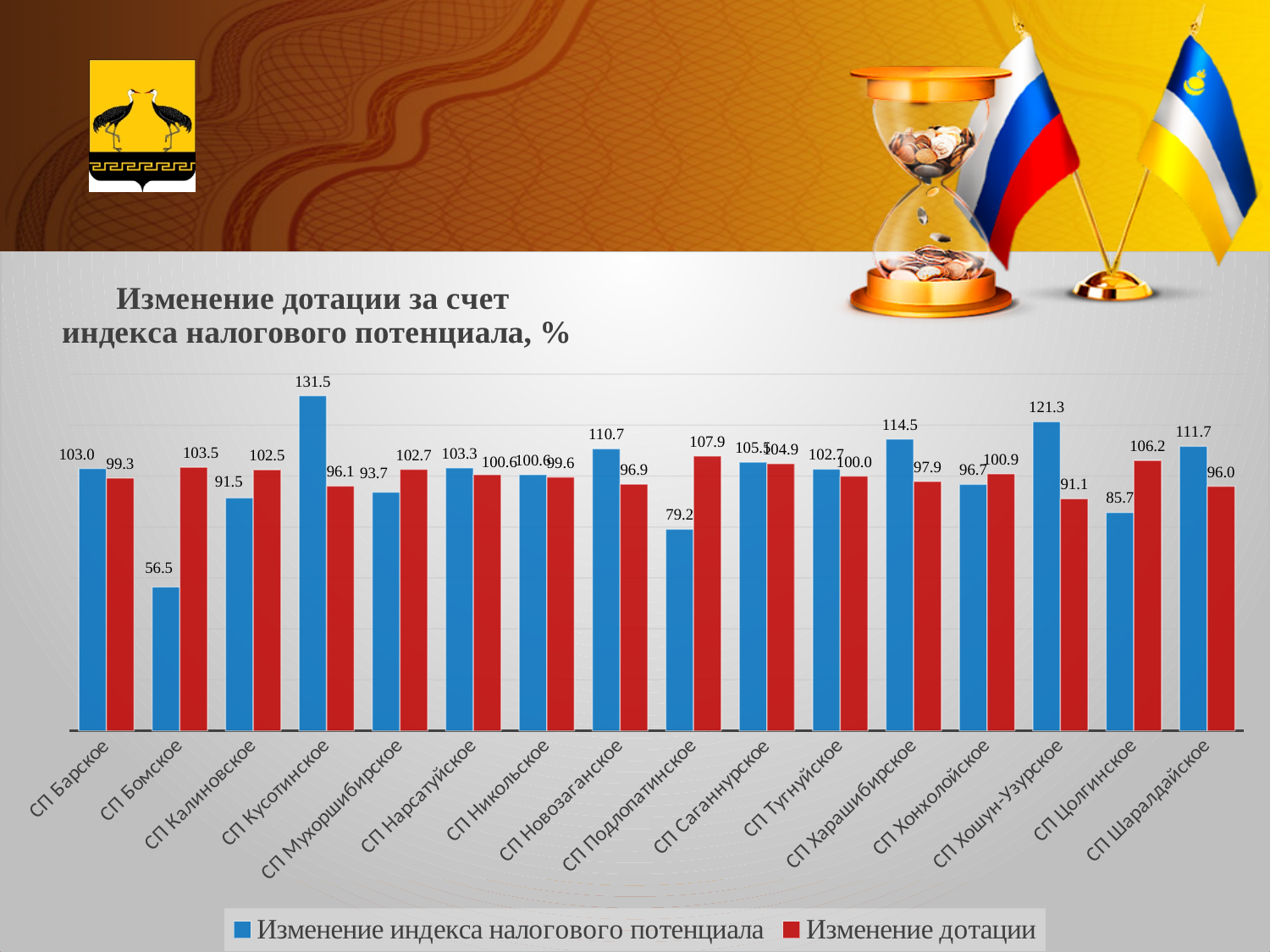
Which colour represents Изменение дотации in the chart? Red For СП Цолгинское, which is larger: Изменение индекса налогового потенциала or Изменение дотации? Изменение дотации How many series does the legend list? 2 Which category has the lowest value for Изменение индекса налогового потенциала? СП Бомское What is the value of Изменение индекса налогового потенциала for СП Кусотинское? 131.5 What is the value of Изменение индекса налогового потенциала for СП Бомское? 56.5 Which category has the highest value for Изменение индекса налогового потенциала? СП Кусотинское What kind of chart is shown on the slide? Bar chart What is the difference between Изменение индекса налогового потенциала and Изменение дотации for СП Хошун-Узурское? 30.2 Which category has the lowest value for Изменение дотации? СП Хошун-Узурское What is the value of Изменение дотации for СП Подлопатинское? 107.9 How many categories are shown on the x axis? 16